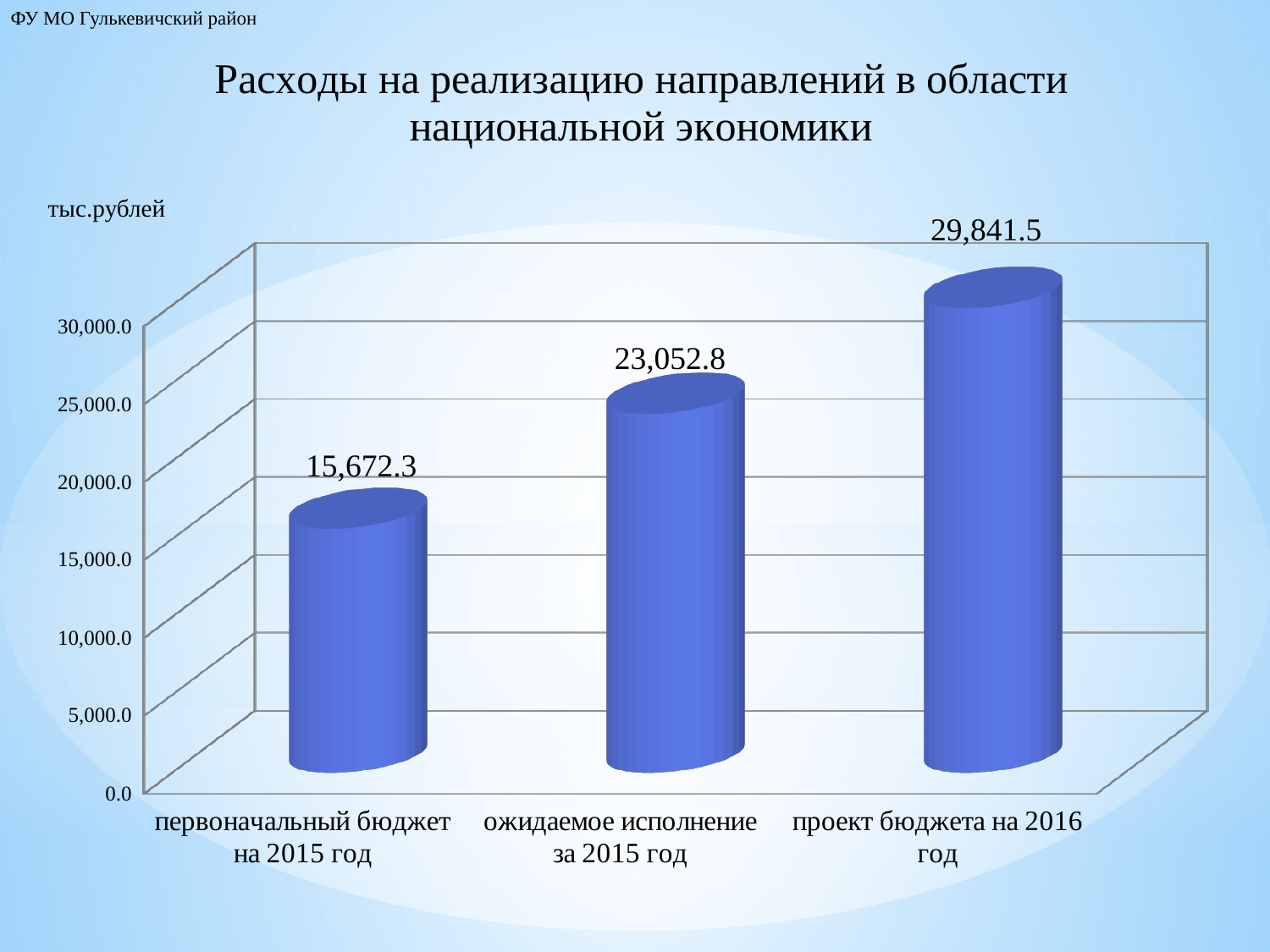
What kind of chart is shown on the slide? bar chart Which category has the lowest value? первоначальный бюджет на 2015 год Which category has the highest value? проект бюджета на 2016 год What is the value for «проект бюджета на 2016 год»? 29,841.5 What is the difference between «проект бюджета на 2016 год» and «ожидаемое исполнение за 2015 год»? 6,788.7 What is the difference between «ожидаемое исполнение за 2015 год» and «первоначальный бюджет на 2015 год»? 7,380.5 What is the value for «первоначальный бюджет на 2015 год»? 15,672.3 What is the value for «ожидаемое исполнение за 2015 год»? 23,052.8 Do the values rise or fall from left to right across the categories? rise Which is larger: «проект бюджета на 2016 год» or «первоначальный бюджет на 2015 год»? проект бюджета на 2016 год Is the value for «ожидаемое исполнение за 2015 год» greater or less than 20,000.0? greater How many categories are shown on the chart? 3